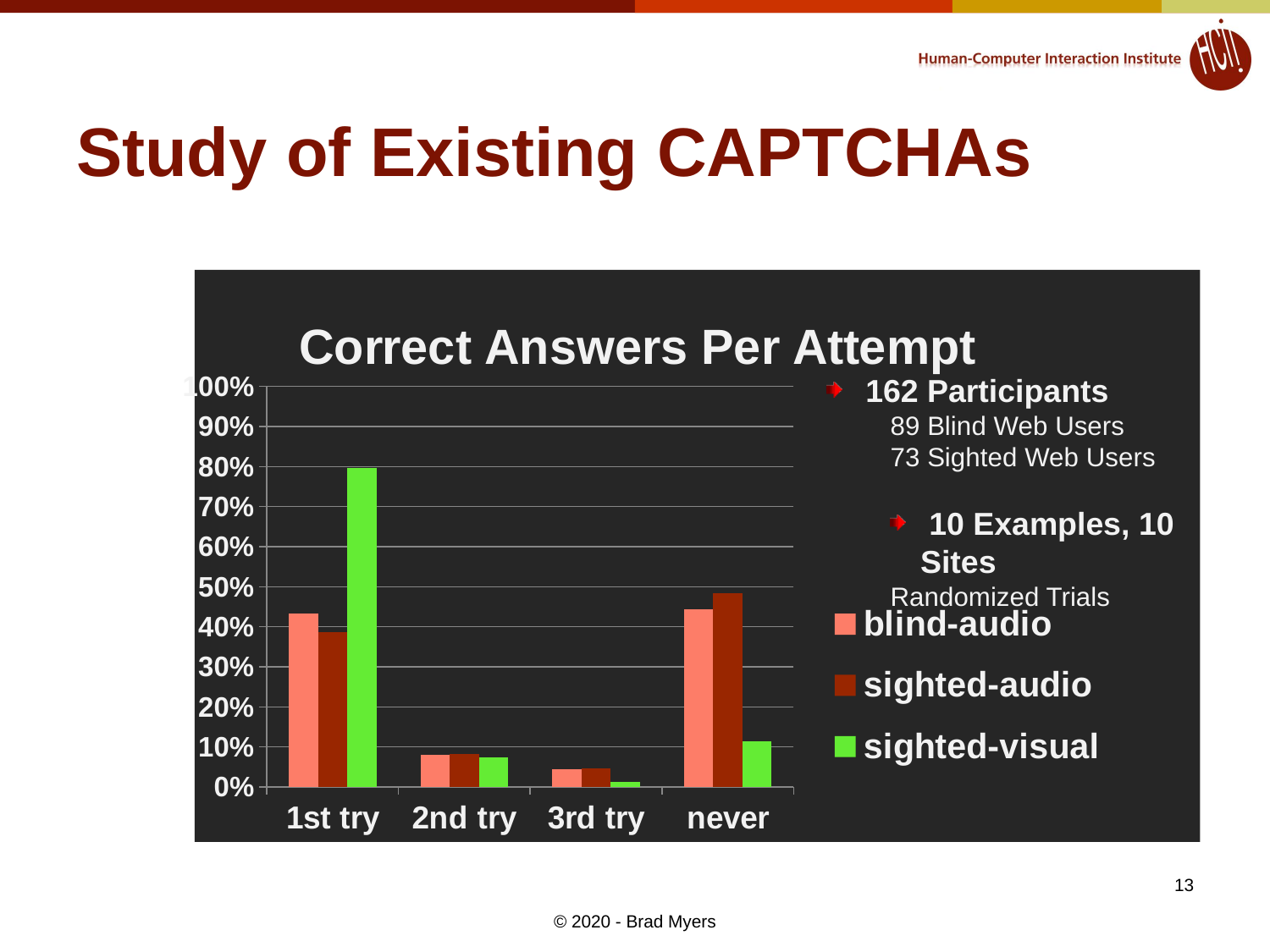
For which category is the sighted-visual value the lowest? 3rd try Which is larger for sighted-visual: the value at 1st try or the value at never? 1st try Which series is shown in green in the chart? sighted-visual What kind of chart is shown on the slide? bar chart Which series has the lowest value in the never category? sighted-visual Is the value for sighted-visual at 1st try greater or less than 70%? greater What is the title of the chart? Correct Answers Per Attempt Is the value for sighted-visual at never greater or less than 20%? less Which series has the highest value in the 1st try category? sighted-visual How many categories are shown on the x axis of the chart? 4 Is the value for blind-audio at 2nd try greater or less than 20%? less How many series does the chart's legend list? 3